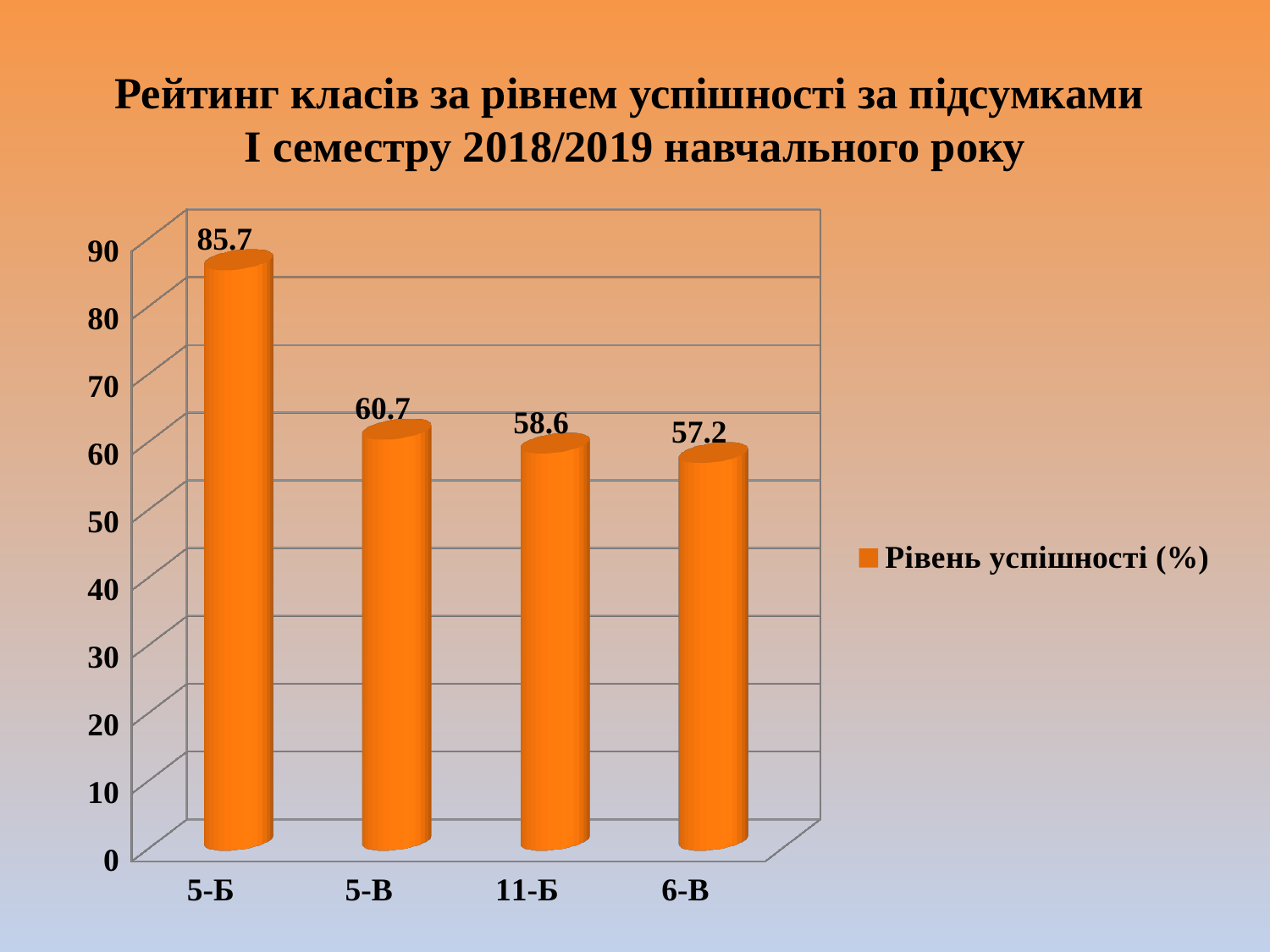
Which class has the highest value? 5-Б What is the difference between the values for 11-Б and 6-В? 1.4 Which is larger, the value for 5-В or the value for 11-Б? 5-В What is the legend entry of the series shown? Рівень успішності (%) What is the value for 11-Б? 58.6 What is the value for 5-Б? 85.7 What is the difference between the values for 5-Б and 5-В? 25 What is the value for 5-В? 60.7 Which class has the lowest value? 6-В What kind of chart is this? bar chart What is the value for 6-В? 57.2 How many classes are shown on the chart? 4